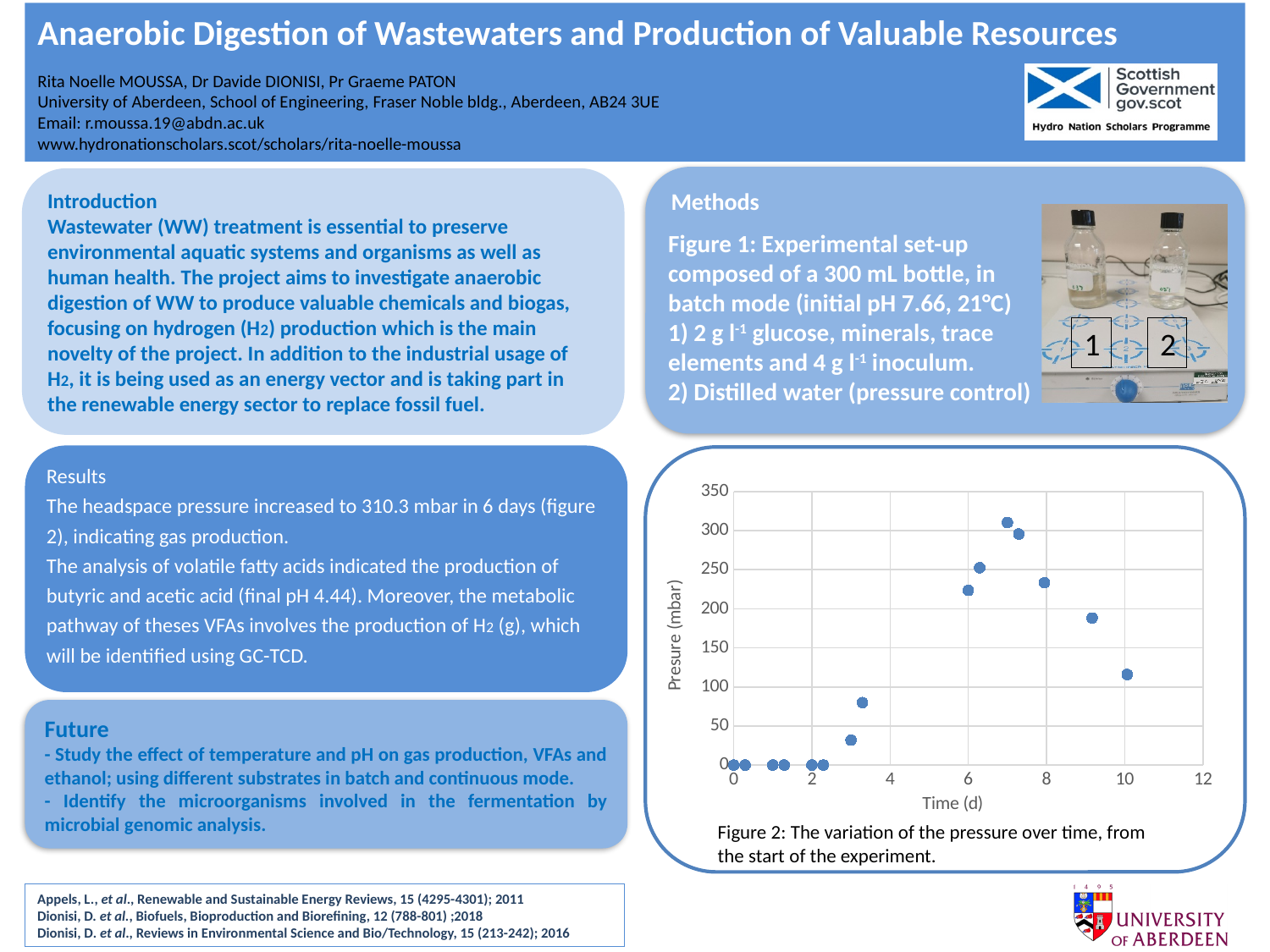
In Figure 2, which is larger: the pressure at day 7 or the pressure at day 8? Day 7 What is the label of the y-axis in Figure 2? Presure (mbar) In Figure 2, does the pressure rise or fall between day 7 and day 10? Fall In Figure 2, is the pressure at day 6 greater or less than 200 mbar? greater In Figure 2, does the pressure rise or fall between day 2 and day 7? Rise In Figure 2, is the highest pressure point greater or less than 300 mbar? greater In Figure 2, is the pressure at day 3 greater or less than 50 mbar? less In Figure 2, which is larger: the pressure at day 6 or the pressure at day 10? Day 6 What is the label of the x-axis in Figure 2? Time (d) What kind of chart is Figure 2 on the slide? Scatter chart